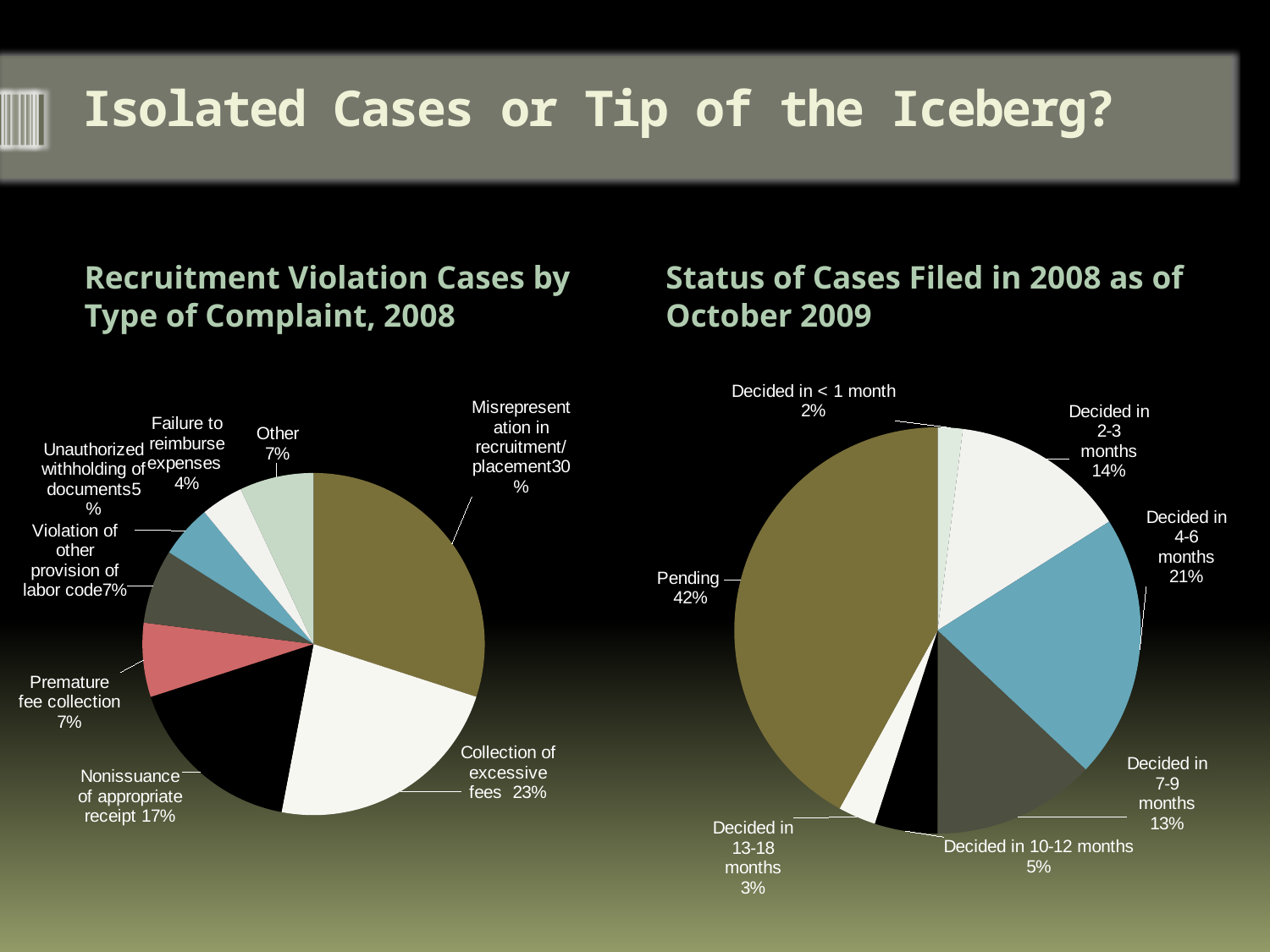
In the 'Status of Cases Filed in 2008 as of October 2009' chart, what share of cases is Pending? 42% In the 'Status of Cases Filed in 2008 as of October 2009' chart, what is the difference in percentage points between Decided in 7-9 months and Decided in 10-12 months? 8 percentage points In the 'Recruitment Violation Cases by Type of Complaint, 2008' chart, what is the difference in percentage points between Misrepresentation in recruitment/placement and Nonissuance of appropriate receipt? 13 percentage points What kind of chart is used for 'Status of Cases Filed in 2008 as of October 2009'? Pie chart In the 'Recruitment Violation Cases by Type of Complaint, 2008' chart, what share is Unauthorized withholding of documents? 5% In the 'Status of Cases Filed in 2008 as of October 2009' chart, how many categories are shown? 7 In the 'Recruitment Violation Cases by Type of Complaint, 2008' chart, which type of complaint has the smallest share? Failure to reimburse expenses In the 'Recruitment Violation Cases by Type of Complaint, 2008' chart, which type of complaint has the largest share? Misrepresentation in recruitment/placement In the 'Status of Cases Filed in 2008 as of October 2009' chart, which category has the smallest share? Decided in < 1 month In the 'Recruitment Violation Cases by Type of Complaint, 2008' chart, how many slices does the pie have? 8 In the 'Status of Cases Filed in 2008 as of October 2009' chart, which is larger: Decided in 2-3 months or Decided in 4-6 months? Decided in 4-6 months In the 'Recruitment Violation Cases by Type of Complaint, 2008' chart, what share of cases is Collection of excessive fees? 23%